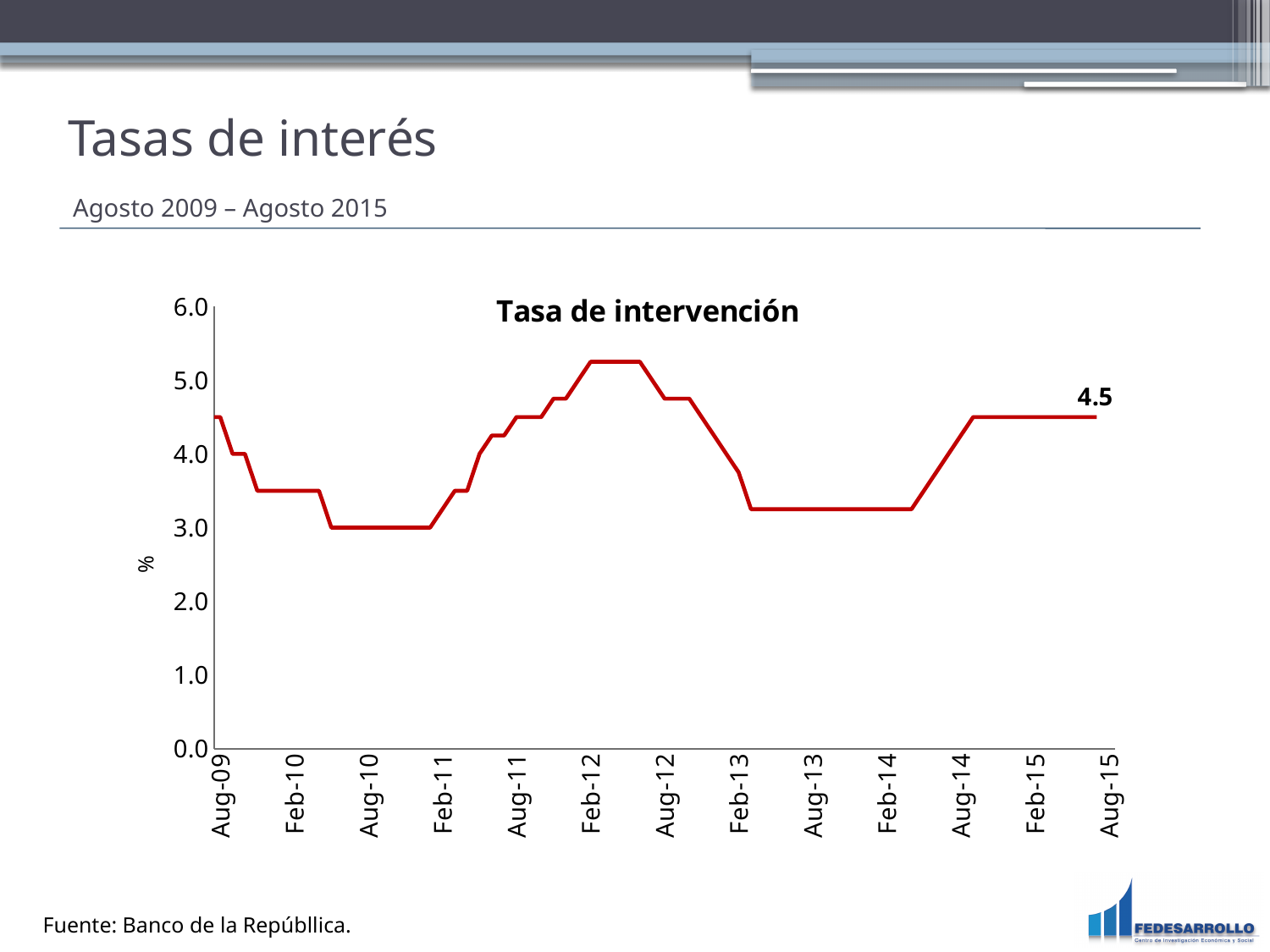
Which is larger, the value at Feb-12 or the value at Aug-10? Feb-12 Is the value for Aug-12 greater or less than 4.0? greater Is the value for Feb-12 greater or less than 5.0? greater Does the intervention rate rise or fall between Aug-12 and Feb-13? fall What is the title of the chart? Tasa de intervención Is the value for Aug-13 greater or less than 4.0? less What type of chart is shown on the slide? line chart What unit is shown on the y-axis label of the chart? % How many date labels are shown on the x-axis of the chart? 13 Does the intervention rate rise or fall between Feb-14 and Aug-14? rise What is the value of the intervention rate at Aug-15, as labelled on the chart? 4.5